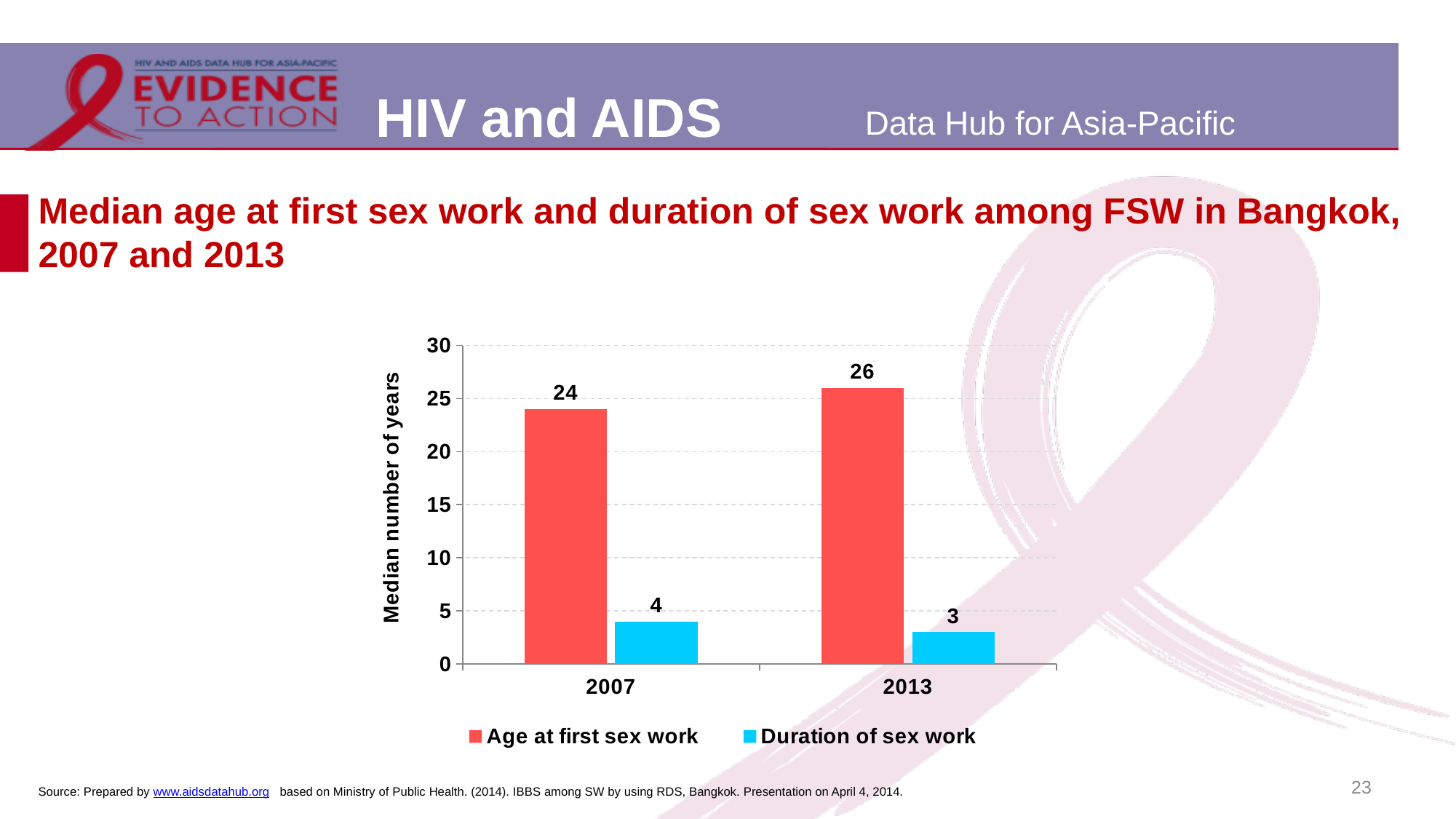
In which year is the median duration of sex work lower? 2013 What is the median duration of sex work in 2013? 3 Is the median duration of sex work in 2007 greater or less than the median duration in 2013? greater What is the median duration of sex work in 2007? 4 In which year is the median age at first sex work higher? 2013 How many series does the legend list? 2 What is the median age at first sex work in 2013? 26 What kind of chart is shown on the slide? bar chart What is the difference between the median age at first sex work and the median duration of sex work in 2013? 23 By how many years did the median age at first sex work increase from 2007 to 2013? 2 What is the median age at first sex work in 2007? 24 Does the median age at first sex work rise or fall from 2007 to 2013? rise